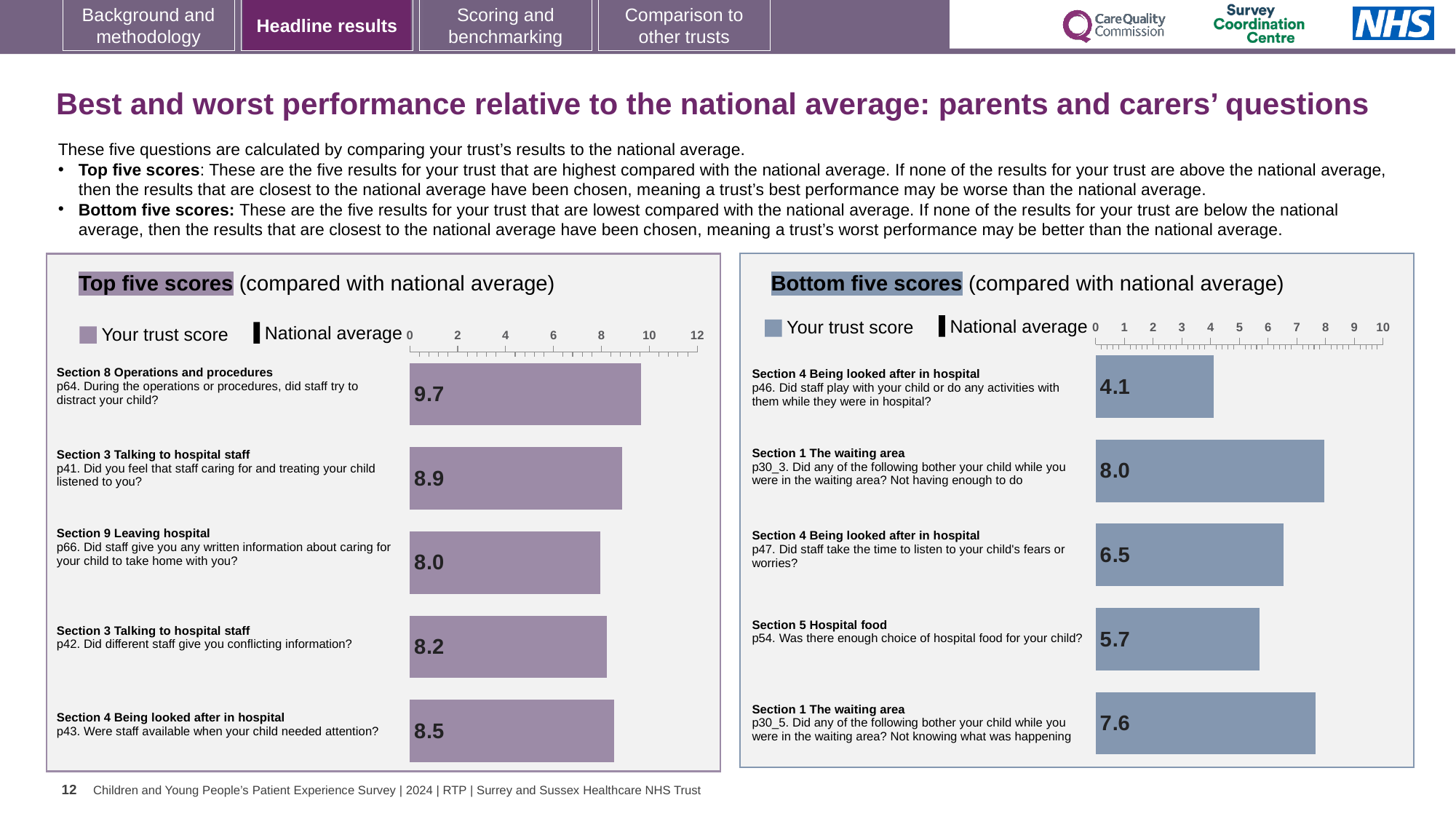
In the Bottom five scores chart, what is the trust score for p46 (Did staff play with your child or do any activities with them while they were in hospital?)? 4.1 In the Bottom five scores chart, what is the trust score for p54 (Was there enough choice of hospital food for your child?)? 5.7 In the Bottom five scores chart, which is larger: the trust score for p47 or for p30_5? p30_5 What kind of chart is the Top five scores chart? Bar chart In the Bottom five scores chart, what is the difference between the trust scores for p30_3 and p46? 3.9 In the Top five scores chart, which question has the lowest trust score? p66. Did staff give you any written information about caring for your child to take home with you? In the Top five scores chart, what is the trust score for p64 (During the operations or procedures, did staff try to distract your child?)? 9.7 In the Top five scores chart, what is the difference between the trust scores for p64 and p41? 0.8 In the Bottom five scores chart, which question has the highest trust score? p30_3. Did any of the following bother your child while you were in the waiting area? Not having enough to do In the Bottom five scores chart, what two entries does the legend list? Your trust score; National average In the Top five scores chart, what is the trust score for p42 (Did different staff give you conflicting information?)? 8.2 In the Top five scores chart, how many questions are plotted? 5